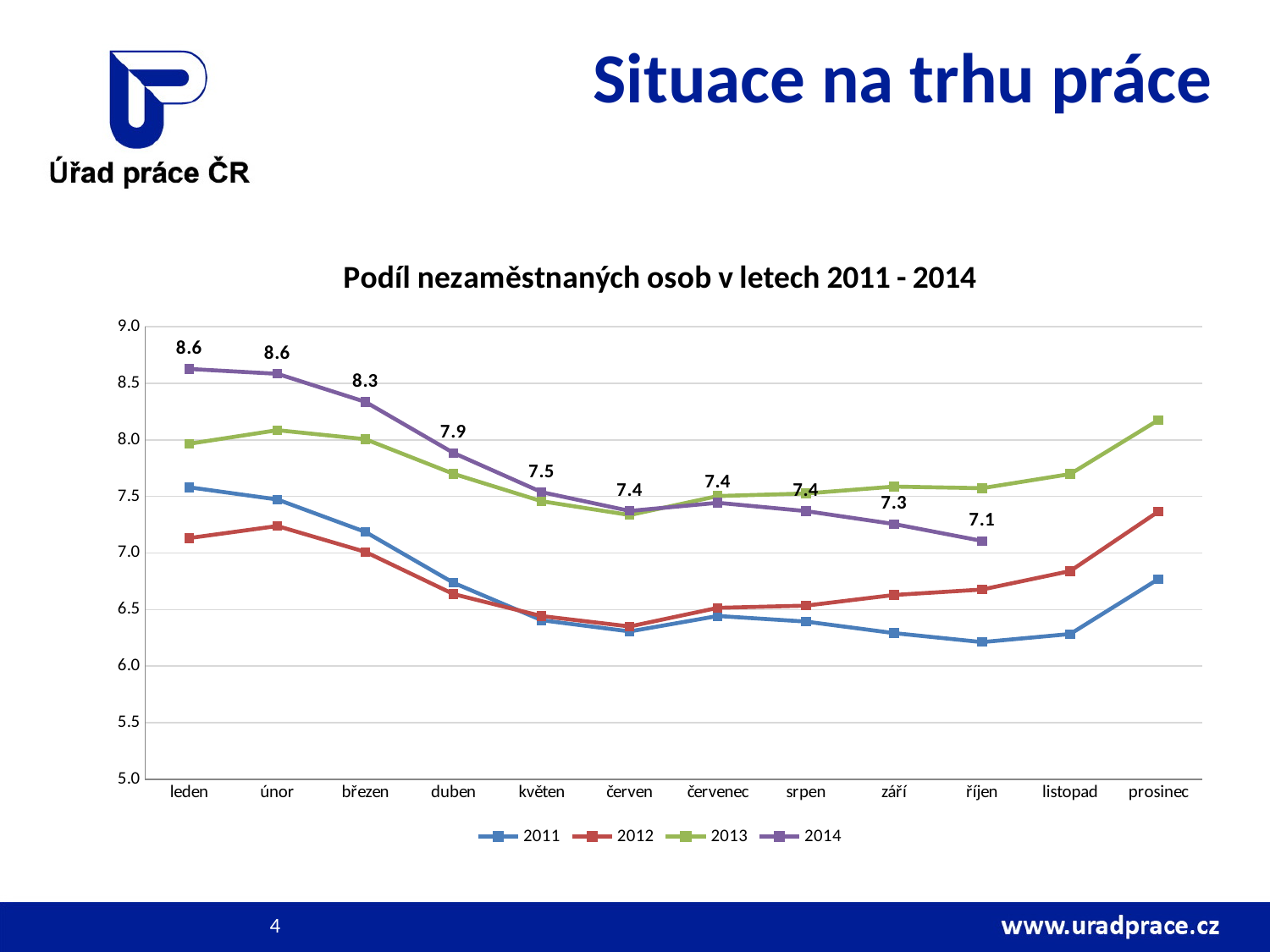
What is the value for 2014 in leden? 8.6 What kind of chart is shown on the slide? line chart In which month is the 2014 series at its lowest? říjen What is the difference between the 2014 values for březen and květen? 0.8 What is the value for 2014 in říjen? 7.1 How many months are shown on the x axis? 12 What is the value for 2014 in duben? 7.9 Does the 2014 series rise or fall from leden to říjen? fall In leden, which series has the higher value, 2013 or 2014? 2014 How many series does the legend list? 4 Is the value for 2011 in říjen greater or less than 6.5? less What is the difference between the 2014 values for leden and říjen? 1.5